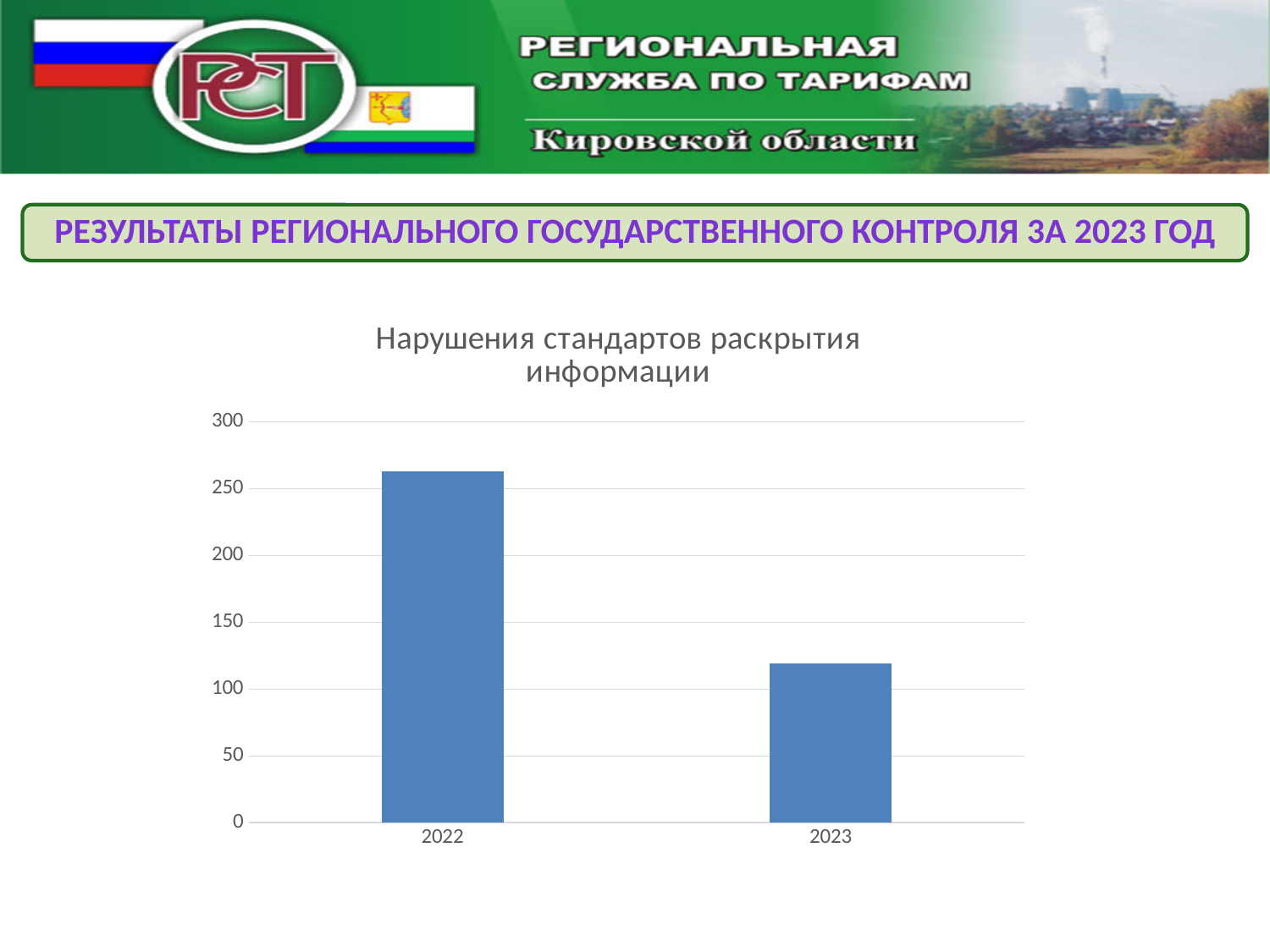
Which year has the lowest value in the chart? 2023 What kind of chart is shown on the slide? bar chart Is the value for 2022 greater or less than 300? less What is the highest value shown on the vertical axis of the chart? 300 Is the value for 2023 greater or less than 100? greater How many categories are shown on the x axis of the chart? 2 Is the value for 2022 greater or less than 250? greater Do the values rise or fall from 2022 to 2023? fall Which is larger, the value for 2022 or the value for 2023? 2022 Which year has the highest value in the chart? 2022 What is the title of the chart? Нарушения стандартов раскрытия информации